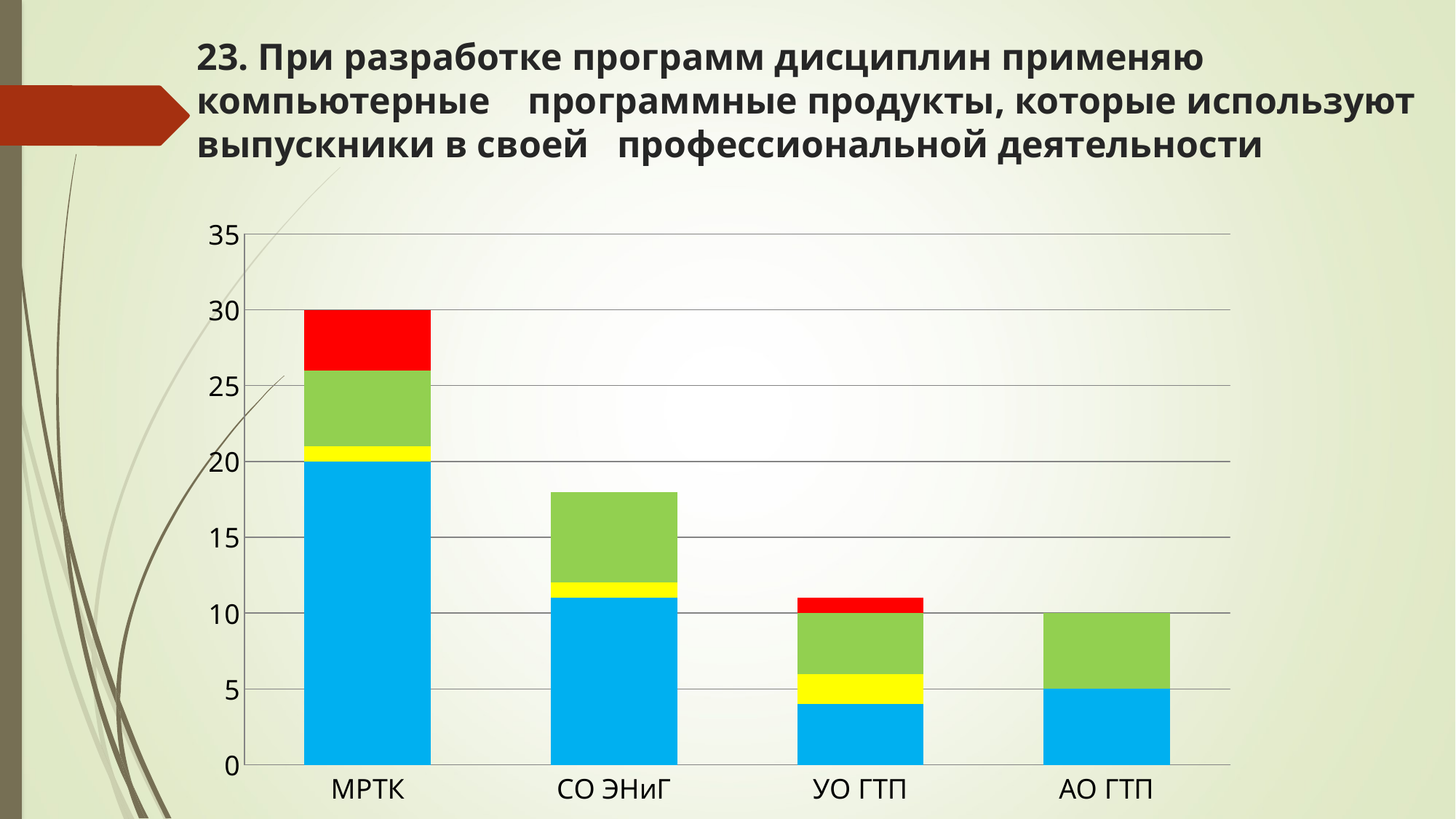
What kind of chart is shown on the slide? bar chart What is the value of the blue (bottom) segment for АО ГТП? 5 Is the total bar height for УО ГТП greater or less than 15? less Which category has the tallest stacked bar? МРТК Do the total bar heights rise or fall from left to right along the x axis? fall What is the value of the blue (bottom) segment for МРТК? 20 What is the difference between the total bar heights of МРТК and АО ГТП? 20 Which has a taller stacked bar, МРТК or СО ЭНиГ? МРТК What is the total height of the stacked bar for МРТК? 30 How many categories are shown on the x axis of the chart? 4 Is the total bar height for СО ЭНиГ greater or less than 20? less What is the total height of the stacked bar for АО ГТП? 10